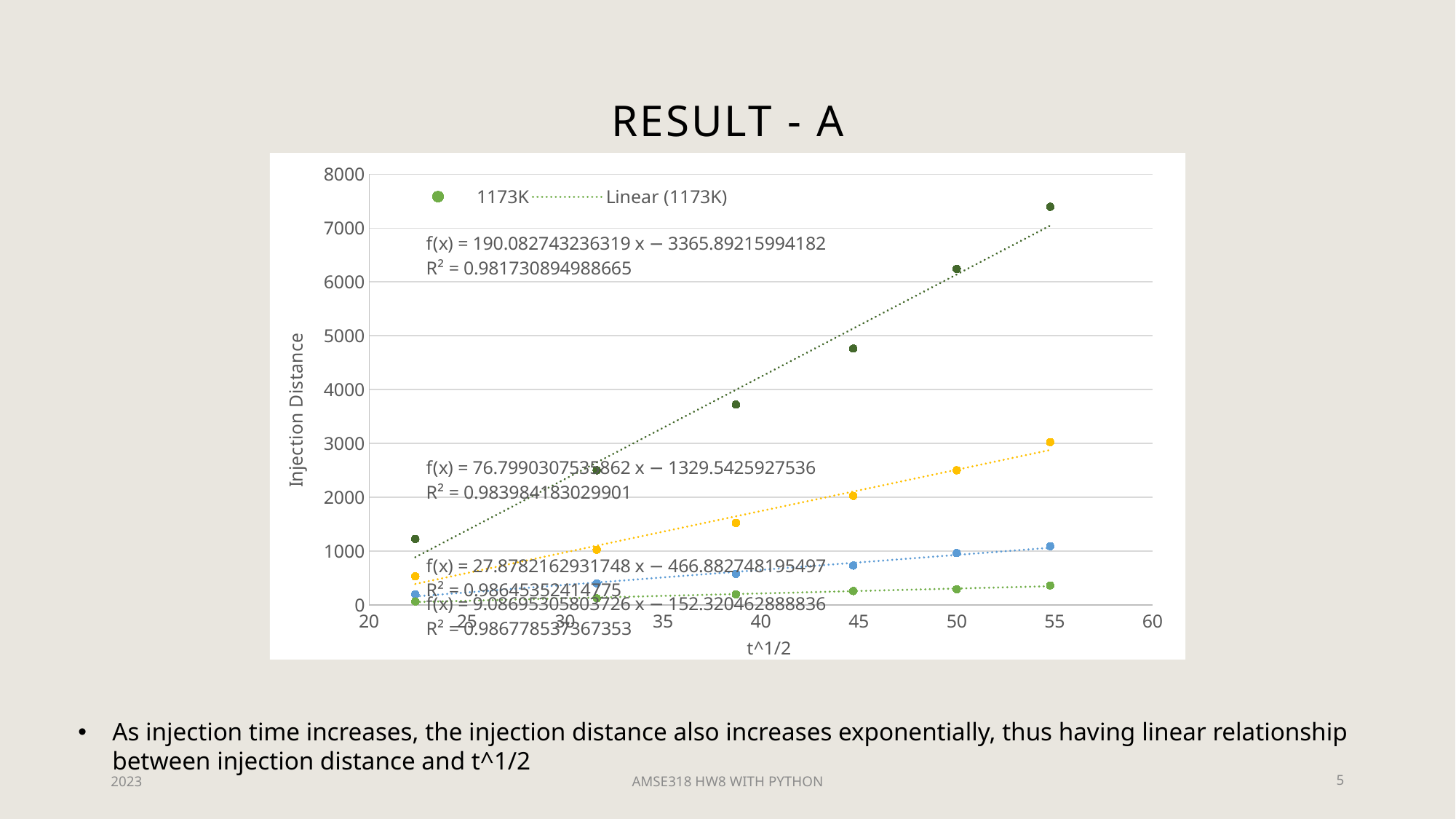
Which of the printed R² values is the lowest? 0.981730894988665 What is the R² value printed for the trendline with slope 190.082743236319? 0.981730894988665 How many data points are plotted for the 1173K series? 6 Which of the printed R² values is the highest? 0.986778537367353 What is the label of the x axis? t^1/2 What kind of chart is shown on the slide? scatter chart What is the slope printed in the trendline equation f(x) = ... x − 1329.5425927536? 76.7990307535862 Do the plotted injection distance values rise or fall as t^1/2 increases? rise Is the highest plotted injection distance value greater or less than 7000? greater How many entries does the chart legend list? 2 Is the largest value of the 1173K series greater or less than 1000? less What series name appears in the chart legend? 1173K